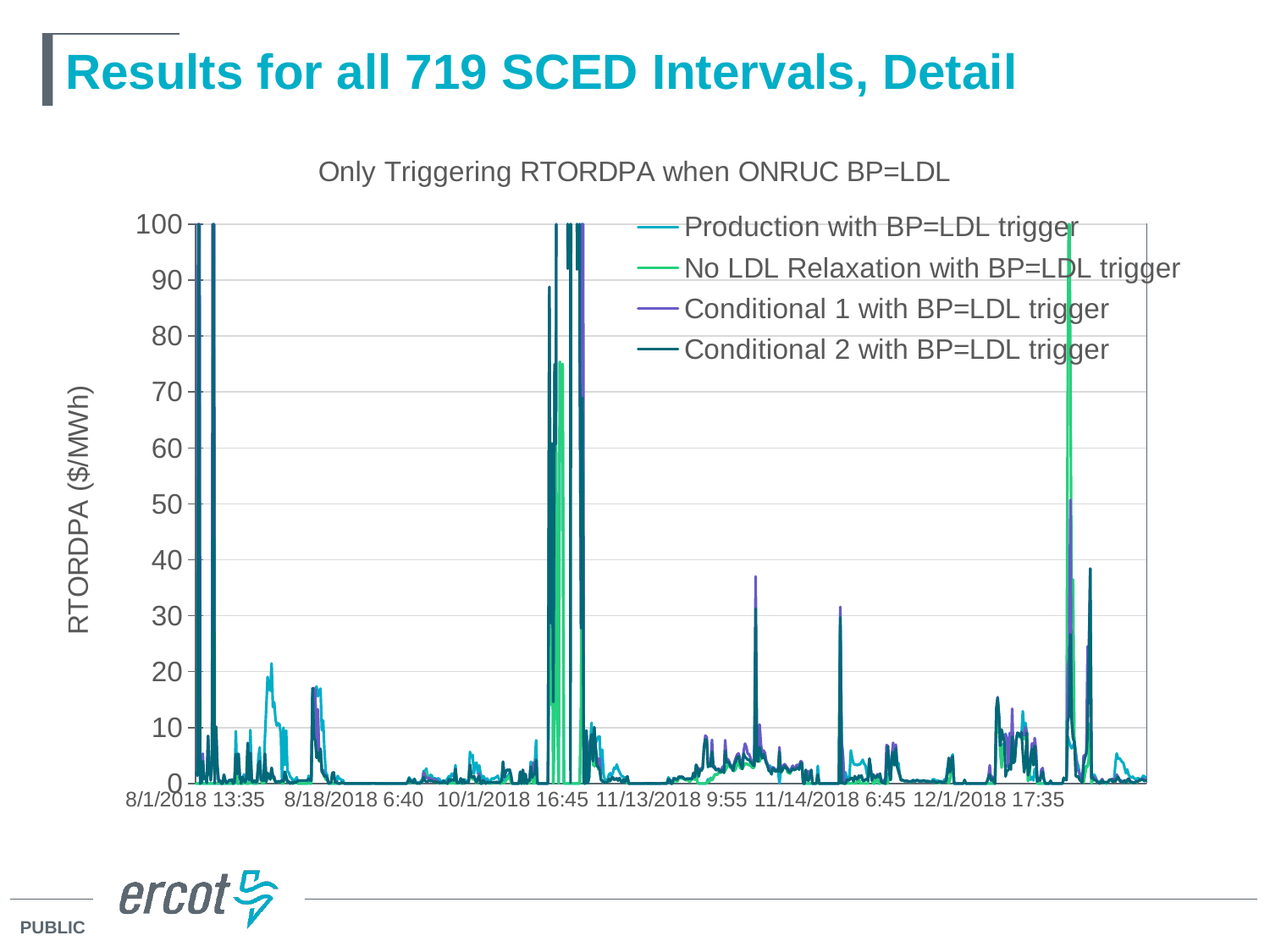
What is the first date label shown on the x axis? 8/1/2018 13:35 What is the title of the chart? Only Triggering RTORDPA when ONRUC BP=LDL What is the label of the y axis? RTORDPA ($/MWh) Which series is listed first in the legend? Production with BP=LDL trigger What is the highest value shown on the y axis? 100 How many date labels are shown along the x axis? 6 What is the last date label shown on the x axis? 12/1/2018 17:35 Is the peak value of the Production with BP=LDL trigger series between 8/1/2018 13:35 and 8/18/2018 6:40 (excluding the spikes at the far left) greater or less than 30? less What kind of chart is shown on the slide? line chart How many series does the legend list? 4 Is the peak value of the No LDL Relaxation with BP=LDL trigger series near 12/1/2018 17:35 greater or less than 90? greater